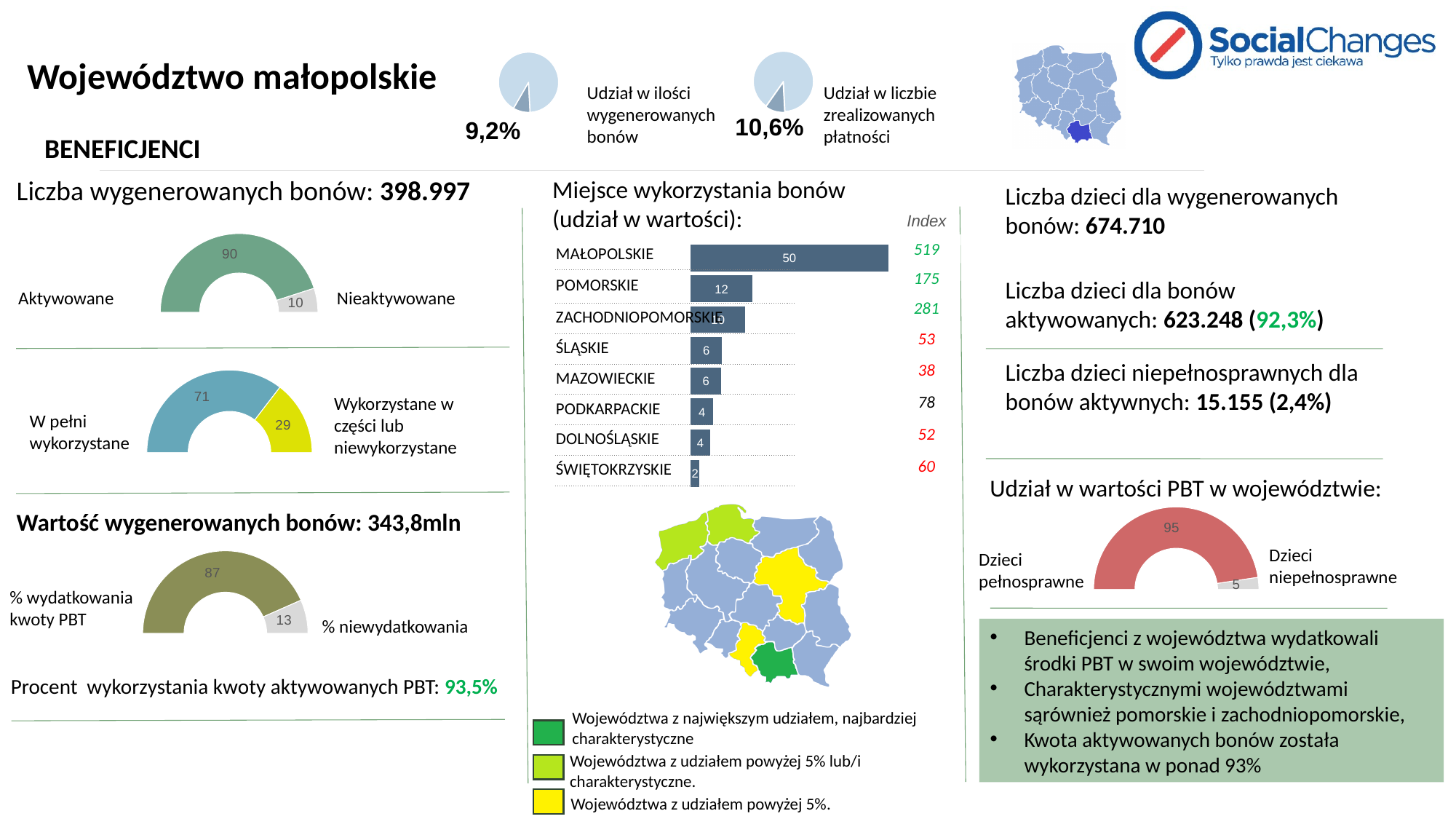
In the half-donut chart under 'Liczba wygenerowanych bonów', what is the value for Aktywowane? 90 In the bar chart 'Miejsce wykorzystania bonów (udział w wartości)', what is the Index value shown for MAŁOPOLSKIE? 519 In the chart 'Udział w wartości PBT w województwie', what is the value for 'Dzieci pełnosprawne'? 95 In the bar chart 'Miejsce wykorzystania bonów (udział w wartości)', which voivodeship has the lowest value? ŚWIĘTOKRZYSKIE In the half-donut chart under 'Wartość wygenerowanych bonów', what is the value for '% niewydatkowania'? 13 In the half-donut chart with 'W pełni wykorzystane', what is the value for 'Wykorzystane w części lub niewykorzystane'? 29 In the bar chart 'Miejsce wykorzystania bonów (udział w wartości)', what is the value for MAŁOPOLSKIE? 50 What kind of chart is 'Miejsce wykorzystania bonów (udział w wartości)'? bar chart In the bar chart 'Miejsce wykorzystania bonów (udział w wartości)', which voivodeship has the highest value? MAŁOPOLSKIE In the bar chart 'Miejsce wykorzystania bonów (udział w wartości)', what is the difference between the values for MAŁOPOLSKIE and POMORSKIE? 38 How many voivodeships are listed in the bar chart 'Miejsce wykorzystania bonów (udział w wartości)'? 8 In the bar chart 'Miejsce wykorzystania bonów (udział w wartości)', which is larger, POMORSKIE or ŚLĄSKIE? POMORSKIE